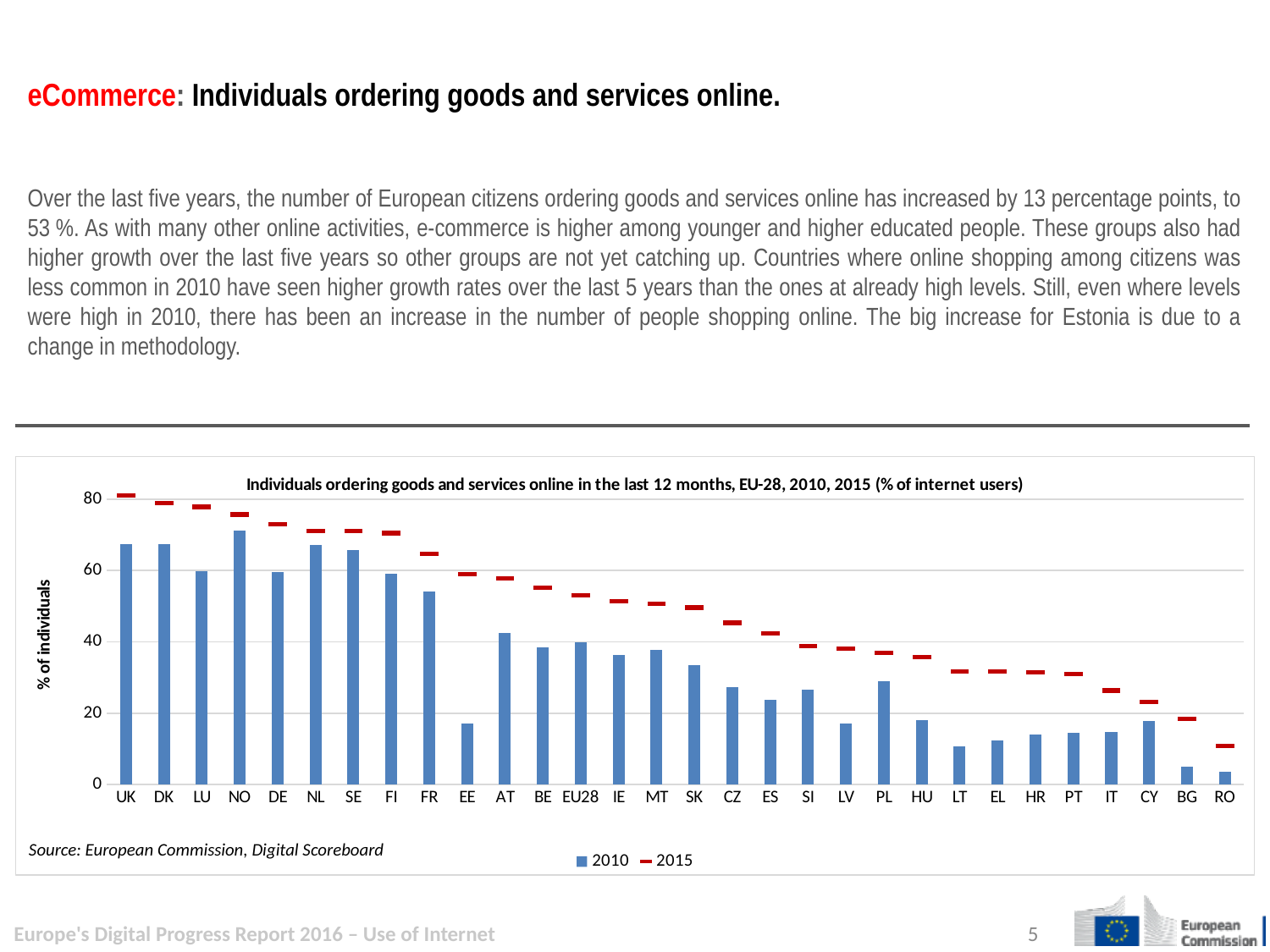
Do the 2015 values generally rise or fall moving from left to right along the x axis? fall How many countries/regions are shown along the x axis of the chart? 30 What kind of chart is shown on the slide? bar chart How many series does the chart legend list? 2 Which is larger, the 2010 value for NO or the 2010 value for DE? NO Is the 2015 value for CZ greater or less than 40? greater Which country has the lowest 2010 value in the chart? RO Is the 2010 value for EE greater or less than 20? less Which country has the highest 2015 value in the chart? UK Which country has the lowest 2015 value in the chart? RO What is the label of the y axis of the chart? % of individuals Is the 2010 value for UK greater or less than 60? greater